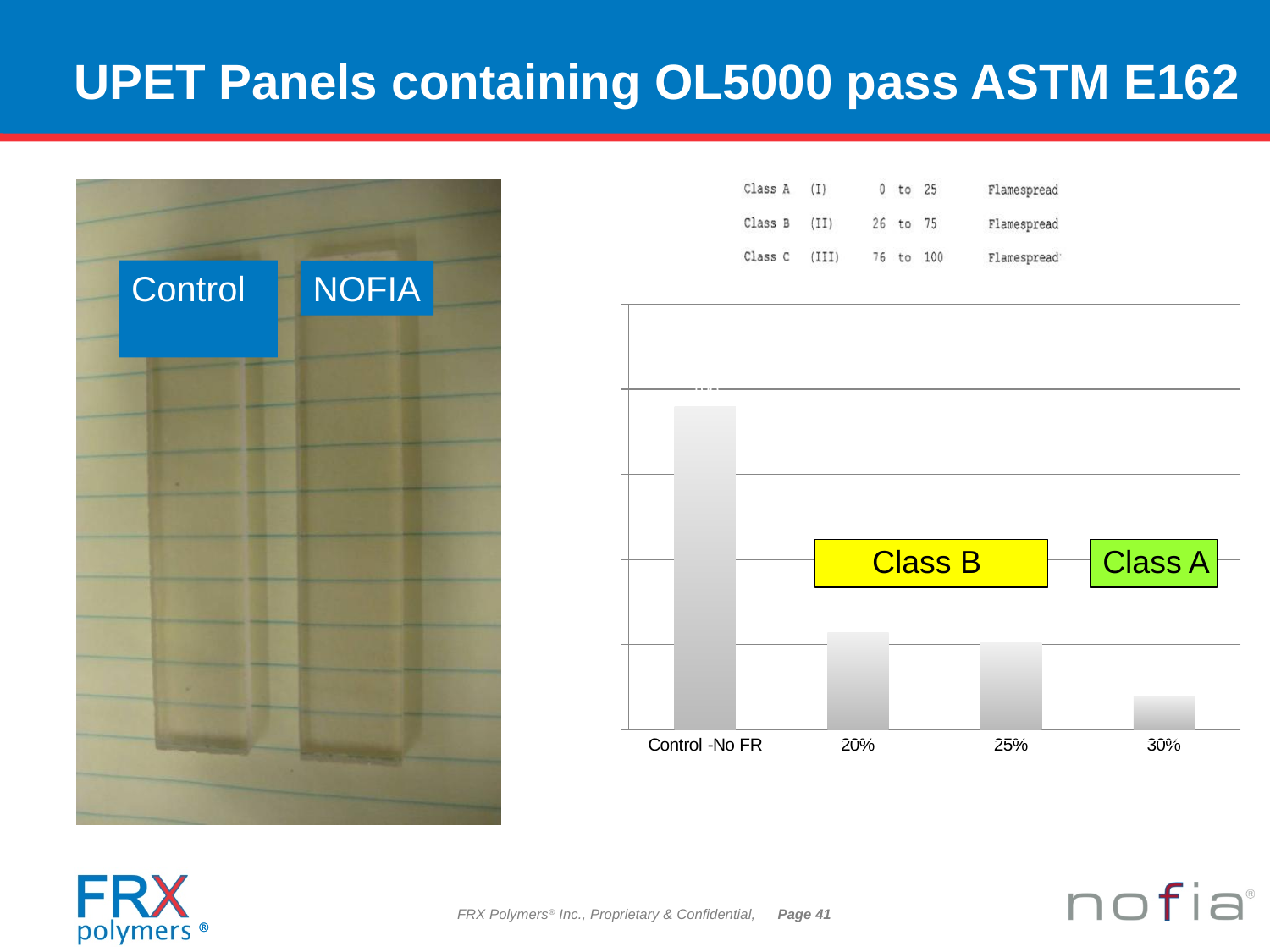
What is the label of the first (leftmost) category on the x axis? Control -No FR What colour is the box labelled 'Class B' on the chart? yellow Which category has the shortest bar in the chart? 30% Which bar is taller, Control -No FR or 20%? Control -No FR Do the bar values rise or fall from left to right across the categories? fall Which bar is taller, Control -No FR or 30%? Control -No FR How many bars are plotted in the chart? 4 Which bar is taller, 25% or 30%? 25% Which category has the tallest bar in the chart? Control -No FR What kind of chart is shown on the slide? bar chart